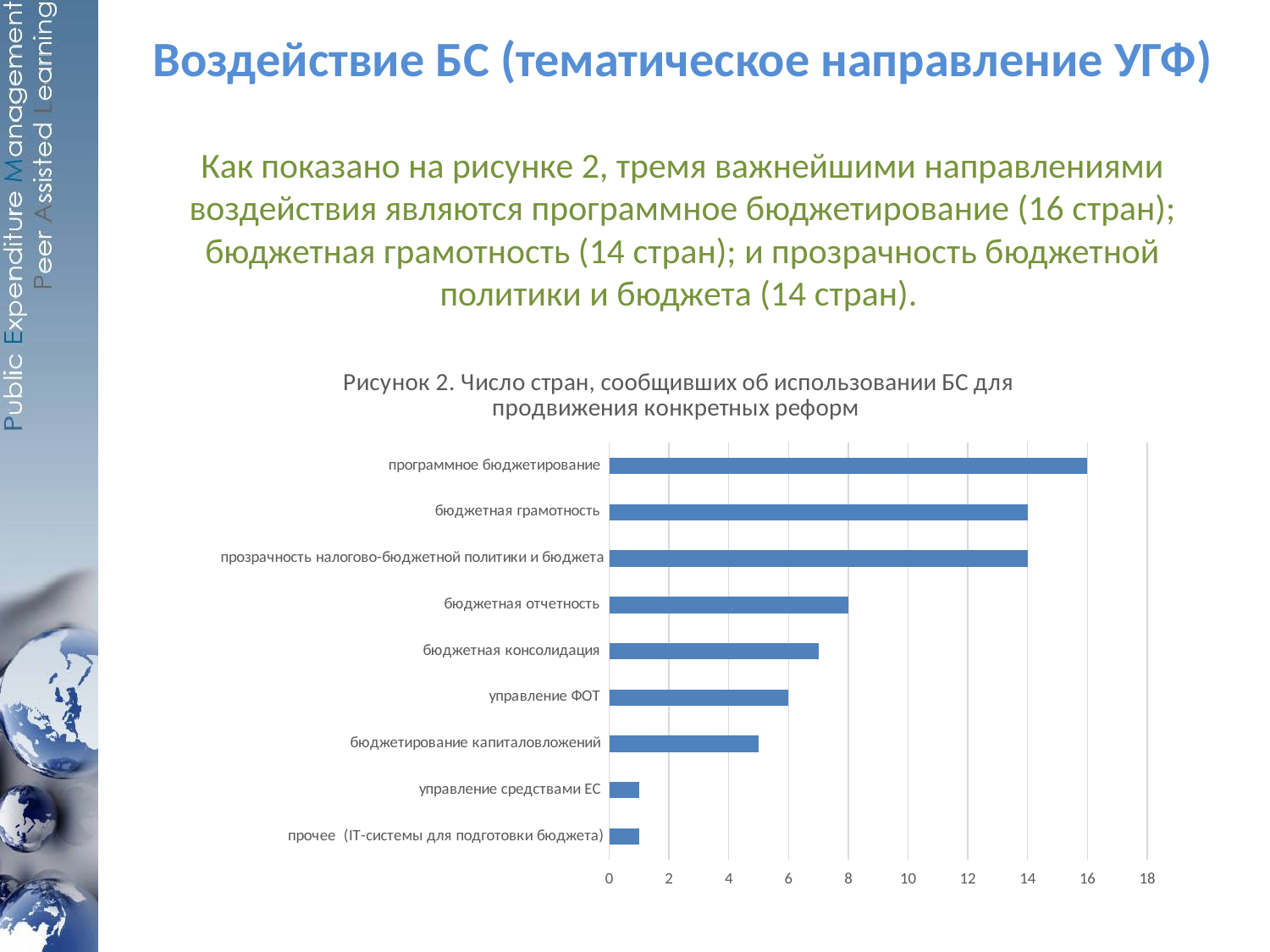
Is the value for бюджетная консолидация greater or less than 6? greater What is the title of the chart? Рисунок 2. Число стран, сообщивших об использовании БС для продвижения конкретных реформ What type of chart is shown on the slide? bar chart Which category has the highest value in the chart? программное бюджетирование What is the value for бюджетная отчетность? 8 Which is larger, the value for бюджетная отчетность or the value for управление ФОТ? бюджетная отчетность How many categories are shown in the chart? 9 What is the difference between the values for программное бюджетирование and бюджетная грамотность? 2 Is the value for управление средствами ЕС greater or less than 2? less What is the value for программное бюджетирование? 16 What is the value for управление ФОТ? 6 What is the value for бюджетная грамотность? 14